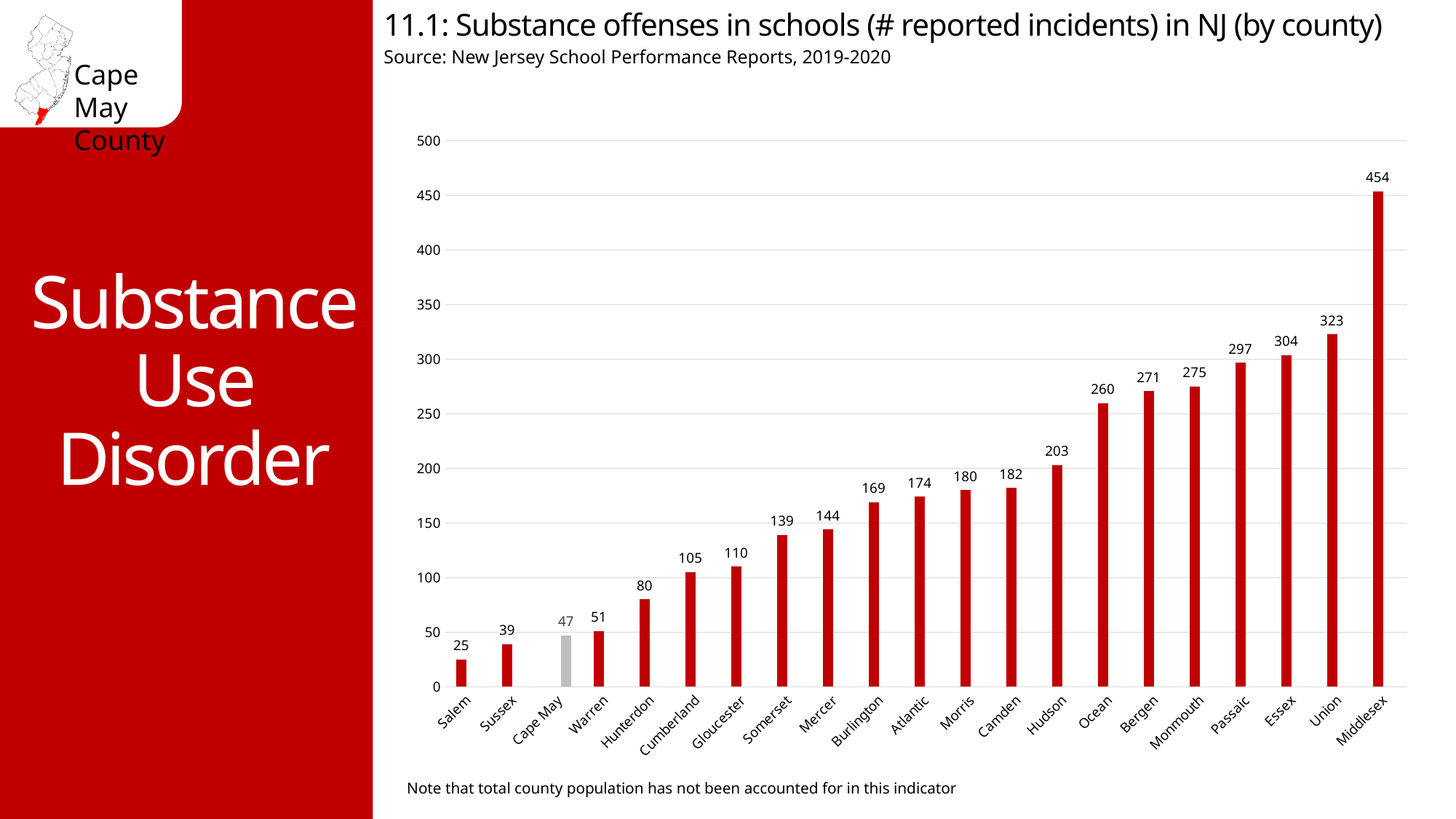
Which county has the lowest number of reported substance offense incidents in schools? Salem Which county has a larger value, Bergen or Ocean? Bergen Which county's bar is coloured grey instead of red? Cape May How many more reported incidents does Middlesex have than Cape May? 407 How many reported incidents are shown for Hudson County? 203 Which county has the highest number of reported substance offense incidents in schools? Middlesex Do the values rise or fall moving from left to right along the x axis? Rise What is the value shown for Middlesex County? 454 What is the number of reported substance offense incidents in schools for Cape May County? 47 How many counties are shown on the x axis of the chart? 21 What is the difference between the values for Union and Essex? 19 What kind of chart is used on this slide? Bar chart